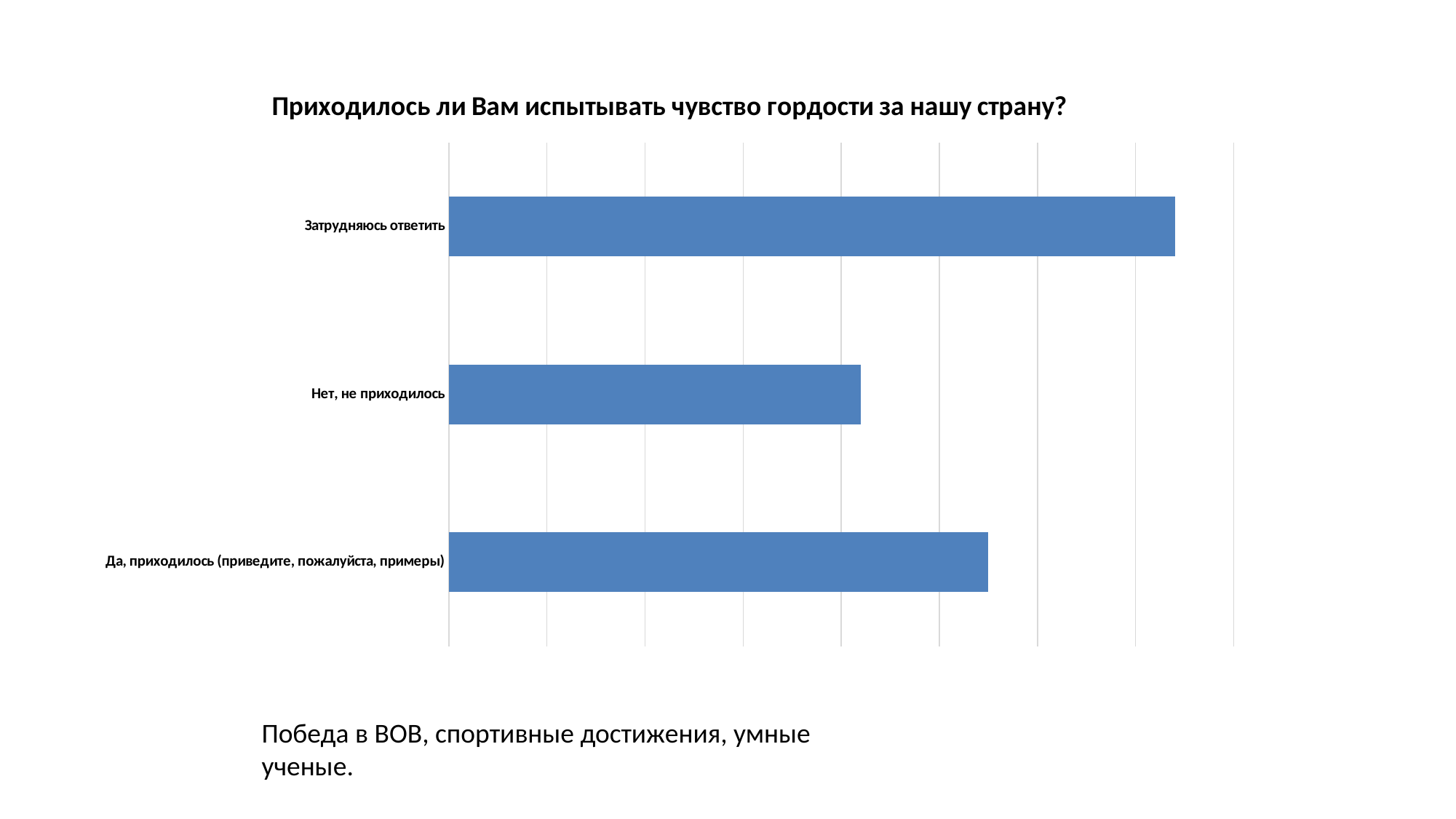
Which category has the longest bar? Затрудняюсь ответить Which bar is longer: "Да, приходилось (приведите, пожалуйста, примеры)" or "Нет, не приходилось"? Да, приходилось (приведите, пожалуйста, примеры) Which bar is longer: "Затрудняюсь ответить" or "Да, приходилось (приведите, пожалуйста, примеры)"? Затрудняюсь ответить Are the bars in the chart horizontal or vertical? horizontal What is the title of the chart? Приходилось ли Вам испытывать чувство гордости за нашу страну? How many categories are plotted in the chart? 3 Which category has the shortest bar? Нет, не приходилось Which bar is longer: "Затрудняюсь ответить" or "Нет, не приходилось"? Затрудняюсь ответить What kind of chart is shown on the slide? bar chart